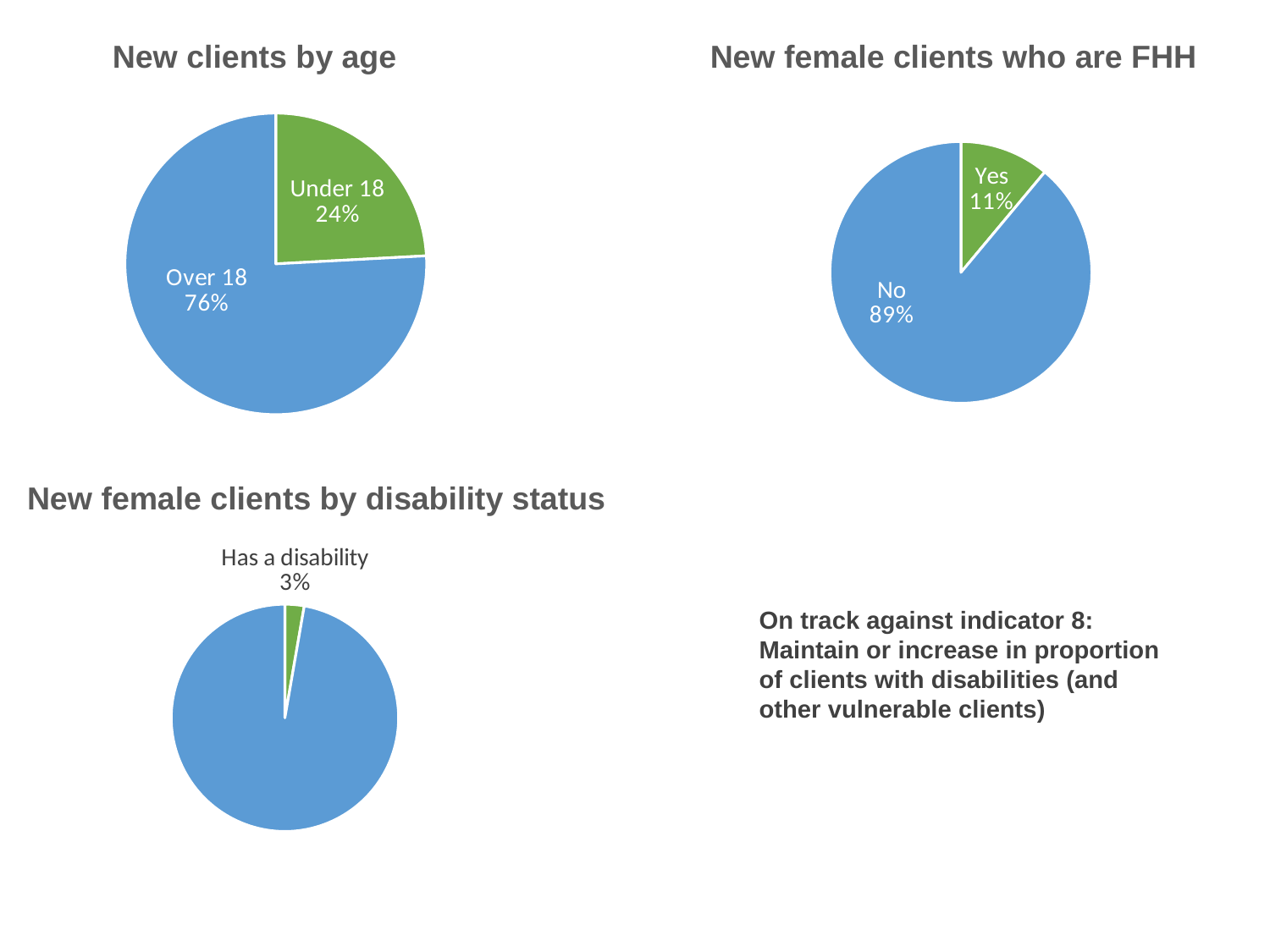
In the 'New female clients who are FHH' chart, which slice is smaller, Yes or No? Yes In the 'New female clients who are FHH' chart, what percentage answered No? 89% In the 'New clients by age' chart, what share of new clients are Under 18? 24% How many slices does the 'New clients by age' pie chart have? 2 How many pie charts are shown on the slide? 3 In the 'New clients by age' chart, what share of new clients are Over 18? 76% In the 'New clients by age' chart, what is the difference in percentage points between Over 18 and Under 18? 52 In the 'New clients by age' chart, which category has the largest slice? Over 18 In the 'New clients by age' chart, what colour is the Under 18 slice? Green What kind of chart is 'New female clients by disability status'? Pie chart